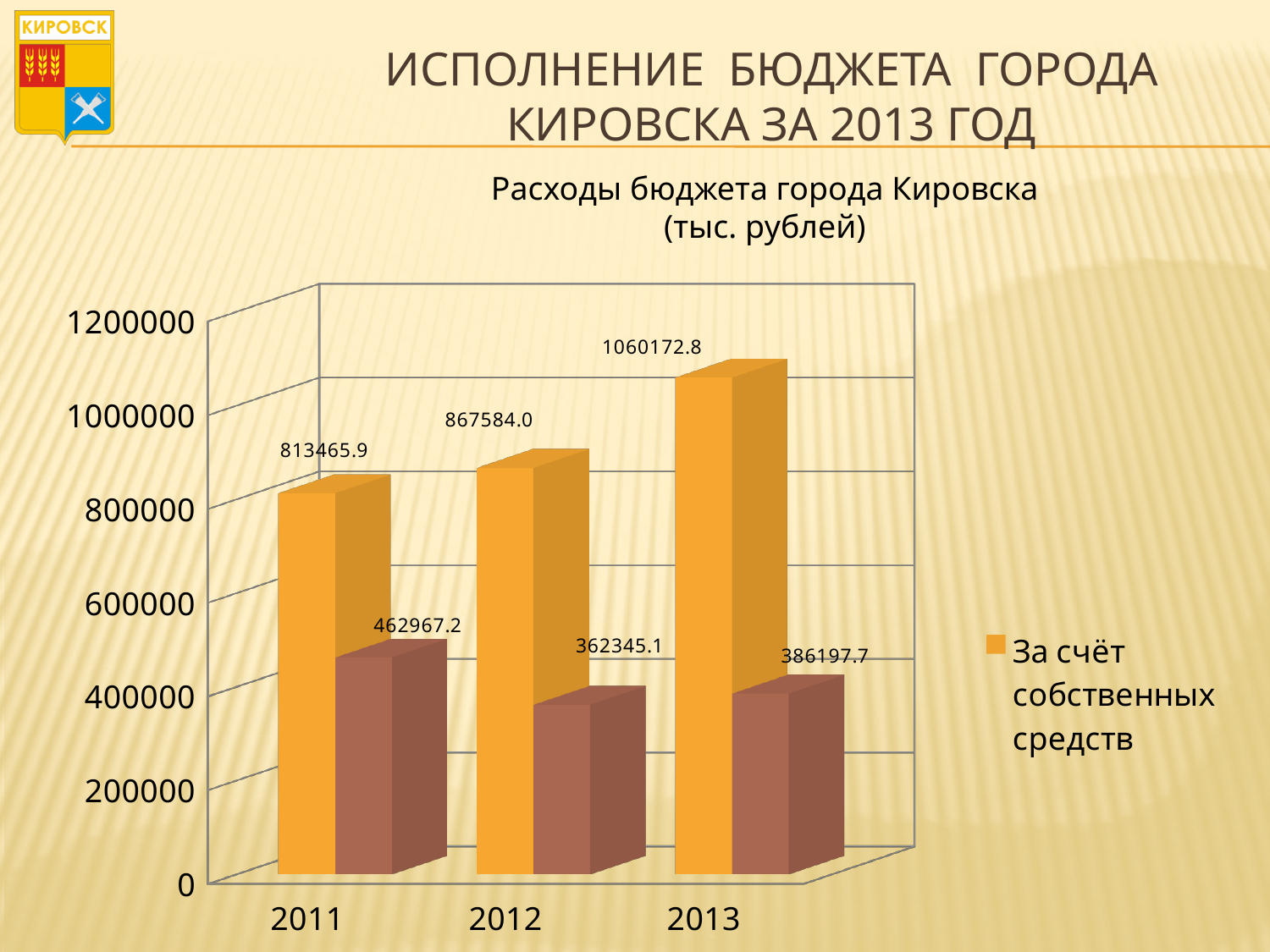
In which year is the orange bar the highest? 2013 In which year is the brown bar the lowest? 2012 Which year has the larger brown bar, 2011 or 2013? 2011 What is the difference between the brown bar values for 2011 and 2012? 100622.1 What is the value of the brown bar for 2011? 462967.2 What is the value of the orange bar for 2012? 867584.0 What is the value of the brown bar for 2012? 362345.1 What is the value of the orange bar for 2013? 1060172.8 What is the difference between the orange bar values for 2013 and 2012? 192588.8 How many years are shown on the x axis? 3 Do the orange bar values rise or fall from 2011 to 2013? Rise What kind of chart is shown on the slide? Bar chart